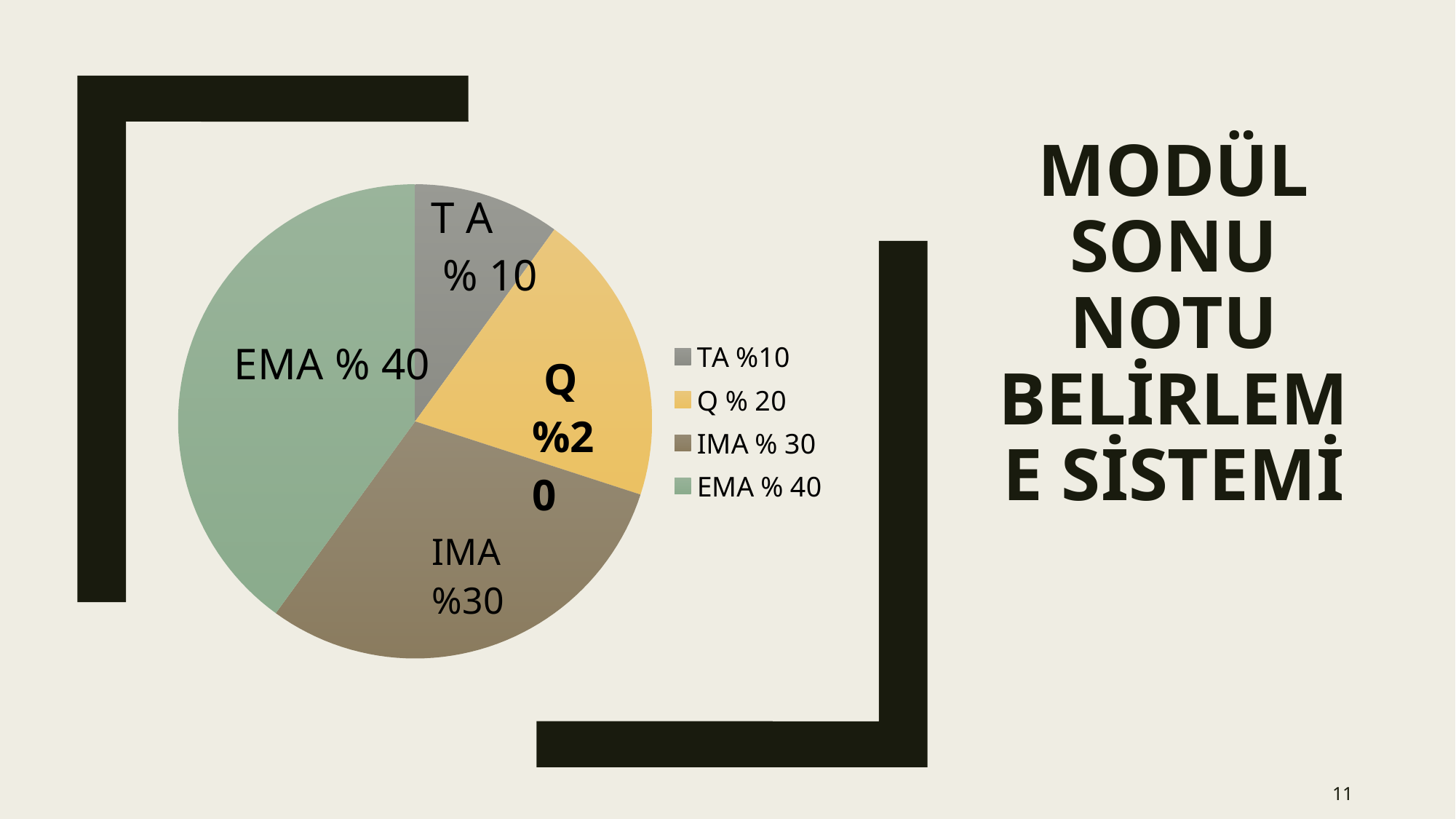
What is the difference in percentage points between the EMA slice and the TA slice? 30 Which is larger, the slice for IMA or the slice for Q? IMA What share of the pie does Q have? % 20 What share of the pie does IMA have? % 30 What share of the pie does EMA have? % 40 What kind of chart is shown on the slide? pie chart What colour is the EMA slice in the pie chart? green Which category has the smallest slice of the pie? TA How many entries does the legend list? 4 Which category has the largest slice of the pie? EMA How many slices does the pie chart have? 4